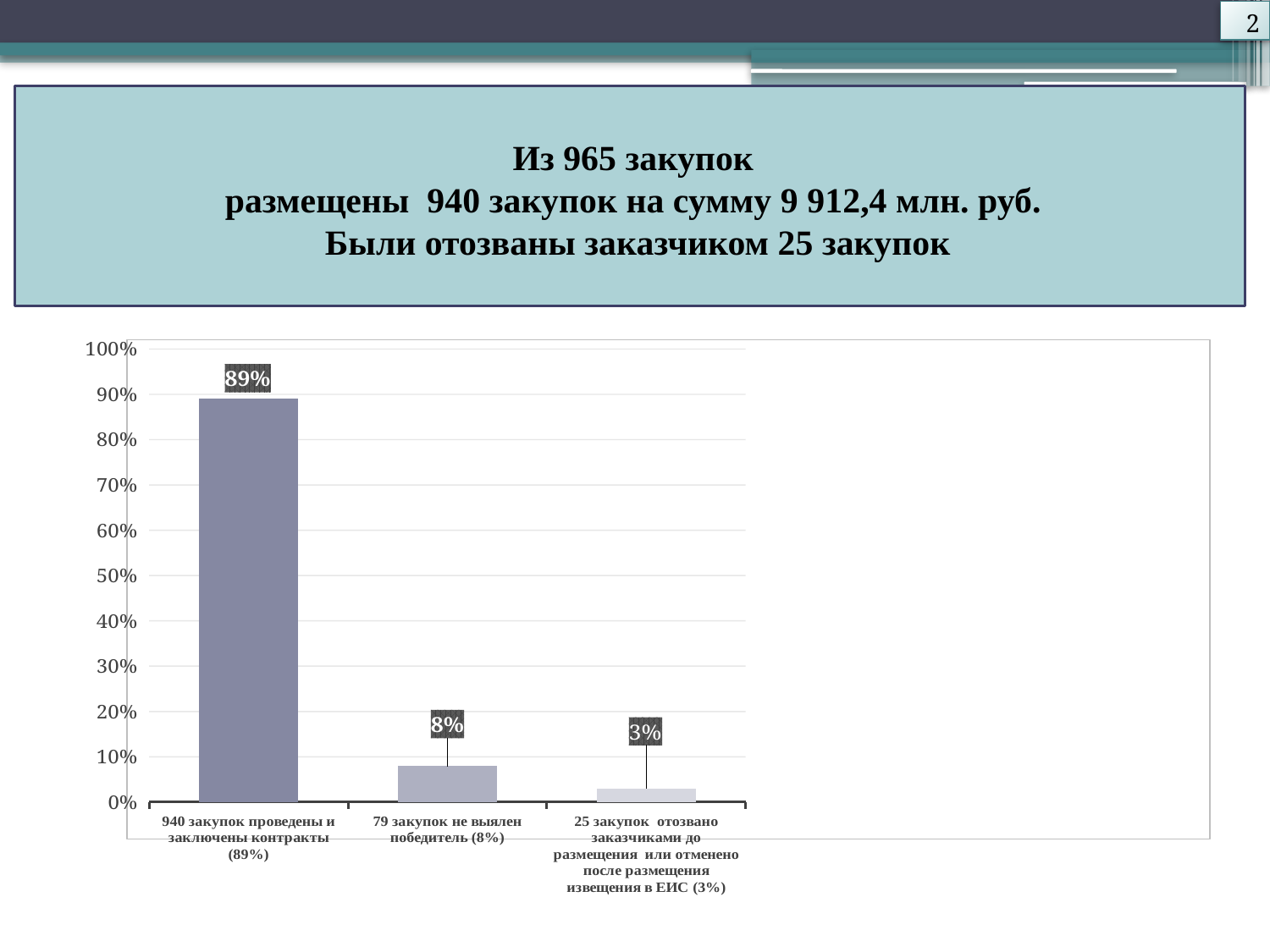
How many categories are shown on the chart? 3 Which category has the lowest value? 25 закупок отозвано заказчиками до размещения или отменено после размещения извещения в ЕИС (3%) What is the value for the category '79 закупок не выялен победитель (8%)'? 8% What is the difference between the value for '79 закупок не выялен победитель' and the value for '25 закупок отозвано заказчиками'? 5% Which category has the highest value? 940 закупок проведены и заключены контракты (89%) What kind of chart is shown on the slide? bar chart What is the value for the category '25 закупок отозвано заказчиками до размещения или отменено после размещения извещения в ЕИС (3%)'? 3% Is the value for '940 закупок проведены и заключены контракты' greater or less than 80%? greater What is the value for the category '940 закупок проведены и заключены контракты (89%)'? 89% Which is larger: the value for '79 закупок не выялен победитель' or the value for '25 закупок отозвано заказчиками'? 79 закупок не выялен победитель (8%) What is the difference between the value for '940 закупок проведены и заключены контракты' and the value for '79 закупок не выялен победитель'? 81% Do the values rise or fall from left to right along the x axis? fall